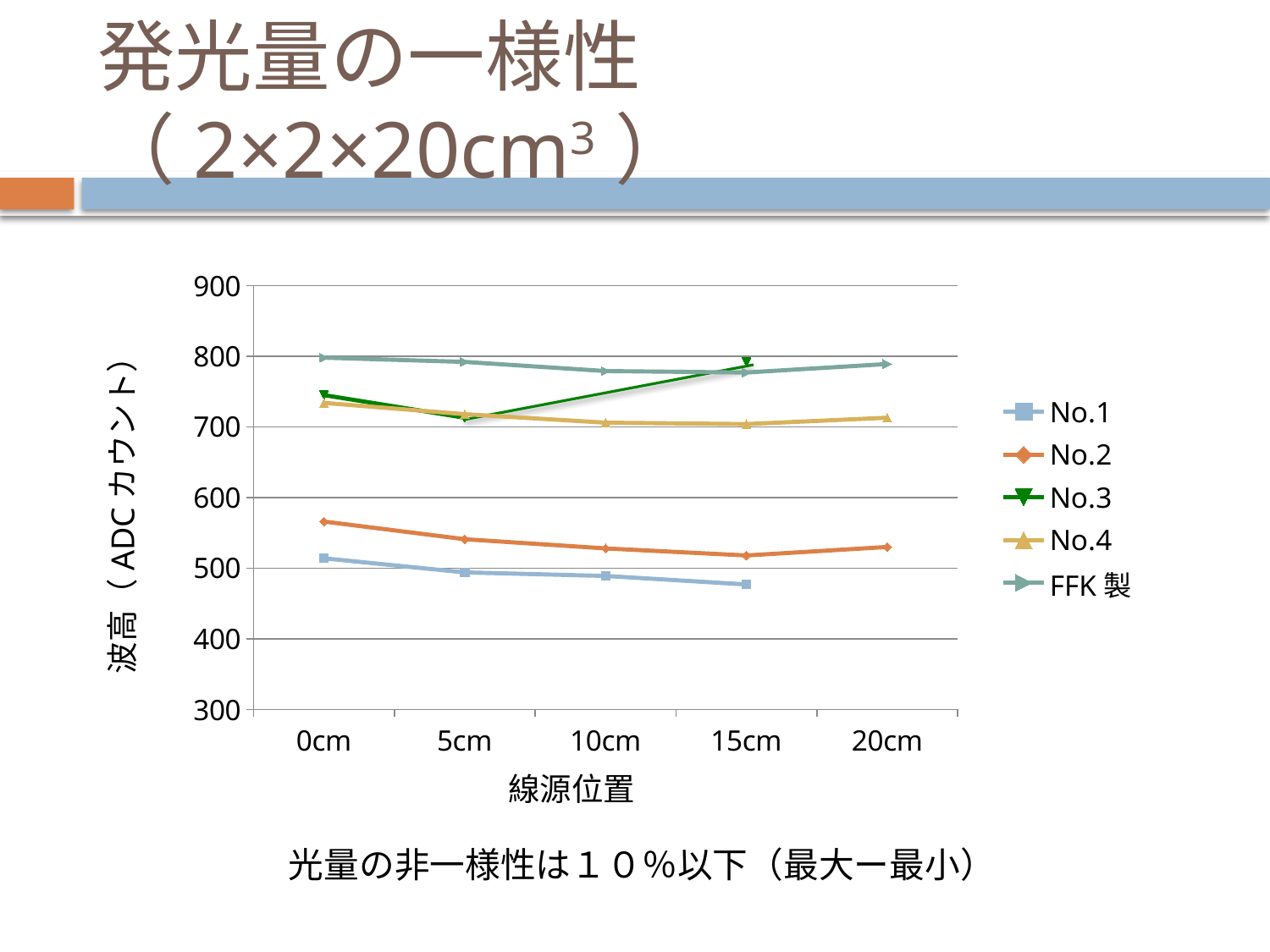
Is the value for No.4 at 0cm greater or less than 700? greater Which series has the lowest value at 0cm? No.1 Is the value for No.2 at 0cm greater or less than 600? less How many source positions are shown on the x axis? 5 How many series does the legend list? 5 Does the No.1 series rise or fall from 0cm to 15cm? fall Is the value for FFK製 at 0cm greater or less than 700? greater At 0cm, which is larger, No.1 or No.2? No.2 Which series has the highest value at 0cm? FFK製 At 15cm, which is larger, No.3 or No.4? No.3 What kind of chart is shown on the slide? line chart